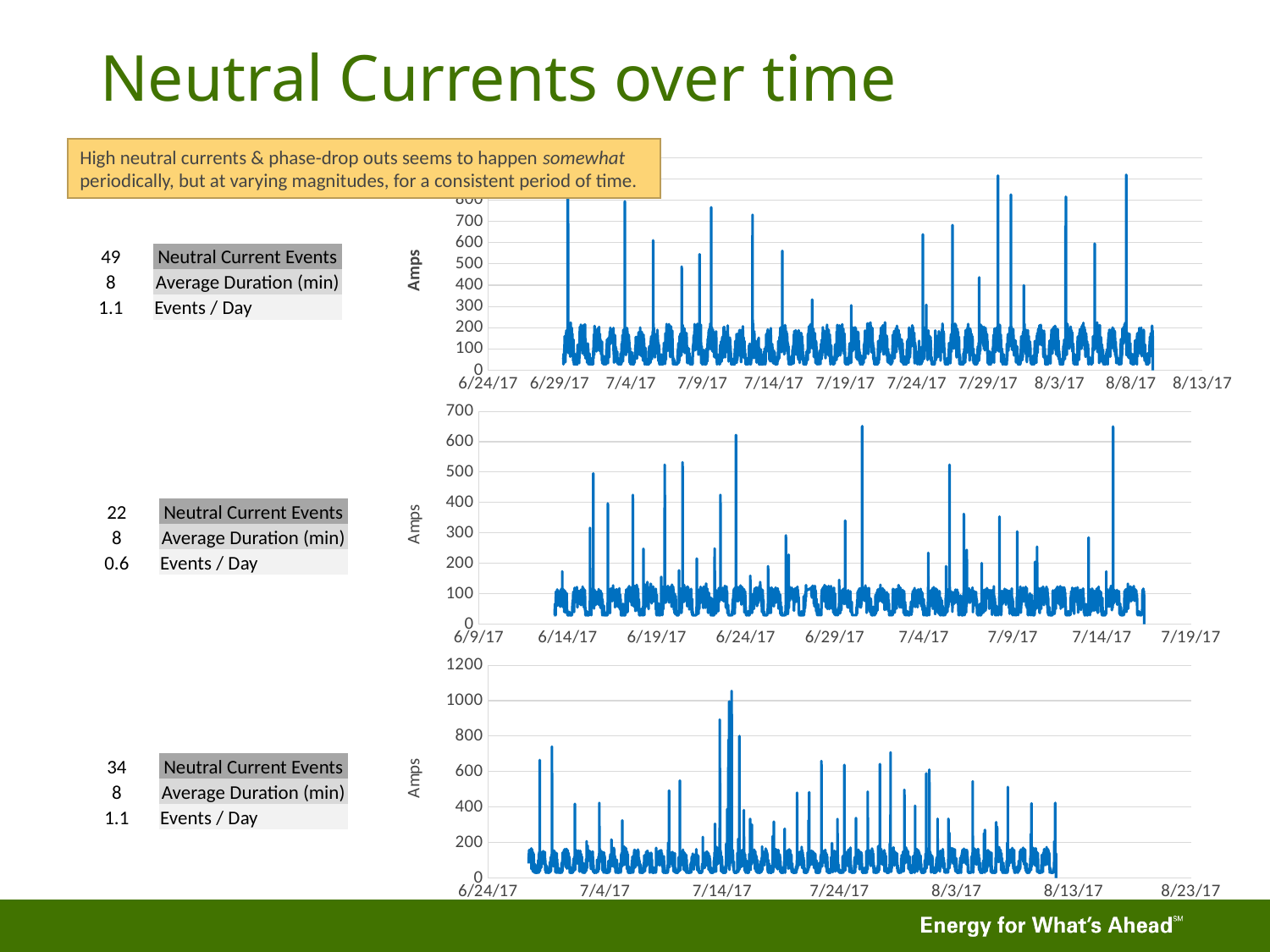
On the bottom chart, what is the highest value shown on the y-axis? 1200 On the bottom chart, is the highest spike (around 7/14/17) greater or less than 1000? greater On the middle chart, is the spike near 6/24/17 greater or less than 500? greater What kind of chart is the top chart on the slide? line chart What is the first date tick on the x-axis of the middle chart? 6/9/17 On the top chart, is the highest spike greater or less than 700? greater What is the y-axis label on the middle chart? Amps What is the last date tick on the x-axis of the bottom chart? 8/23/17 How many Neutral Current Events are listed next to the top chart? 49 How many charts are shown on the slide? 3